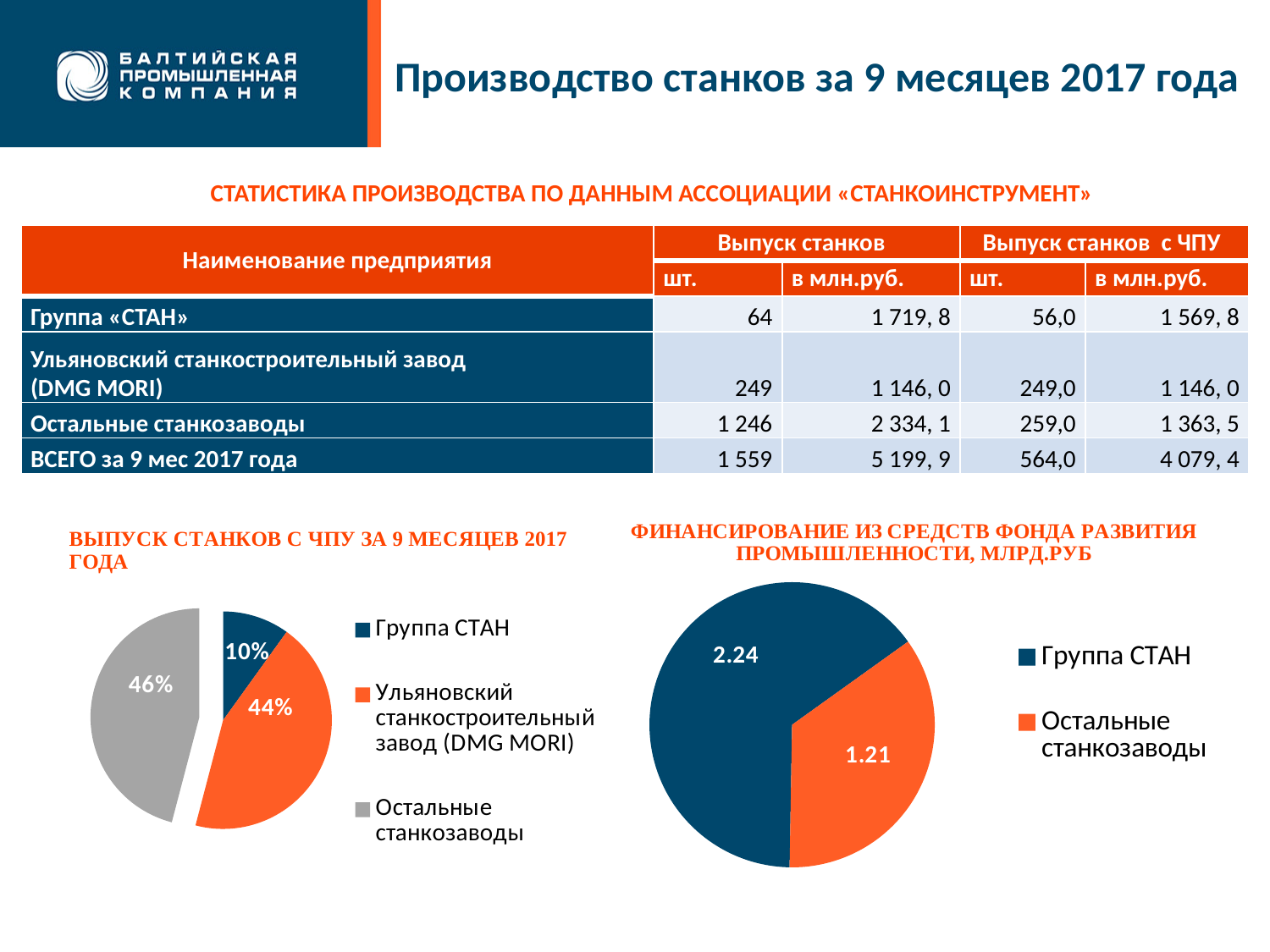
On the left chart (ВЫПУСК СТАНКОВ С ЧПУ ЗА 9 МЕСЯЦЕВ 2017 ГОДА), how many categories does the legend list? 3 On the left chart (ВЫПУСК СТАНКОВ С ЧПУ ЗА 9 МЕСЯЦЕВ 2017 ГОДА), what share does Ульяновский станкостроительный завод (DMG MORI) have? 44% On the right chart (ФИНАНСИРОВАНИЕ ИЗ СРЕДСТВ ФОНДА РАЗВИТИЯ ПРОМЫШЛЕННОСТИ, МЛРД.РУБ), what is the difference between the values for Группа СТАН and Остальные станкозаводы? 1.03 On the right chart (ФИНАНСИРОВАНИЕ ИЗ СРЕДСТВ ФОНДА РАЗВИТИЯ ПРОМЫШЛЕННОСТИ, МЛРД.РУБ), which category received more funding, Группа СТАН or Остальные станкозаводы? Группа СТАН On the left chart (ВЫПУСК СТАНКОВ С ЧПУ ЗА 9 МЕСЯЦЕВ 2017 ГОДА), which category has the smallest share? Группа СТАН On the left chart (ВЫПУСК СТАНКОВ С ЧПУ ЗА 9 МЕСЯЦЕВ 2017 ГОДА), what share does Группа СТАН have? 10% What type of chart is the right chart (ФИНАНСИРОВАНИЕ ИЗ СРЕДСТВ ФОНДА РАЗВИТИЯ ПРОМЫШЛЕННОСТИ, МЛРД.РУБ)? Pie chart On the left chart (ВЫПУСК СТАНКОВ С ЧПУ ЗА 9 МЕСЯЦЕВ 2017 ГОДА), what share do Остальные станкозаводы have? 46% On the right chart (ФИНАНСИРОВАНИЕ ИЗ СРЕДСТВ ФОНДА РАЗВИТИЯ ПРОМЫШЛЕННОСТИ, МЛРД.РУБ), what is the value for Остальные станкозаводы? 1.21 On the left chart (ВЫПУСК СТАНКОВ С ЧПУ ЗА 9 МЕСЯЦЕВ 2017 ГОДА), which category has the largest share? Остальные станкозаводы On the right chart (ФИНАНСИРОВАНИЕ ИЗ СРЕДСТВ ФОНДА РАЗВИТИЯ ПРОМЫШЛЕННОСТИ, МЛРД.РУБ), what is the value for Группа СТАН? 2.24 On the left chart (ВЫПУСК СТАНКОВ С ЧПУ ЗА 9 МЕСЯЦЕВ 2017 ГОДА), what is the difference in percentage points between Остальные станкозаводы and Группа СТАН? 36 percentage points